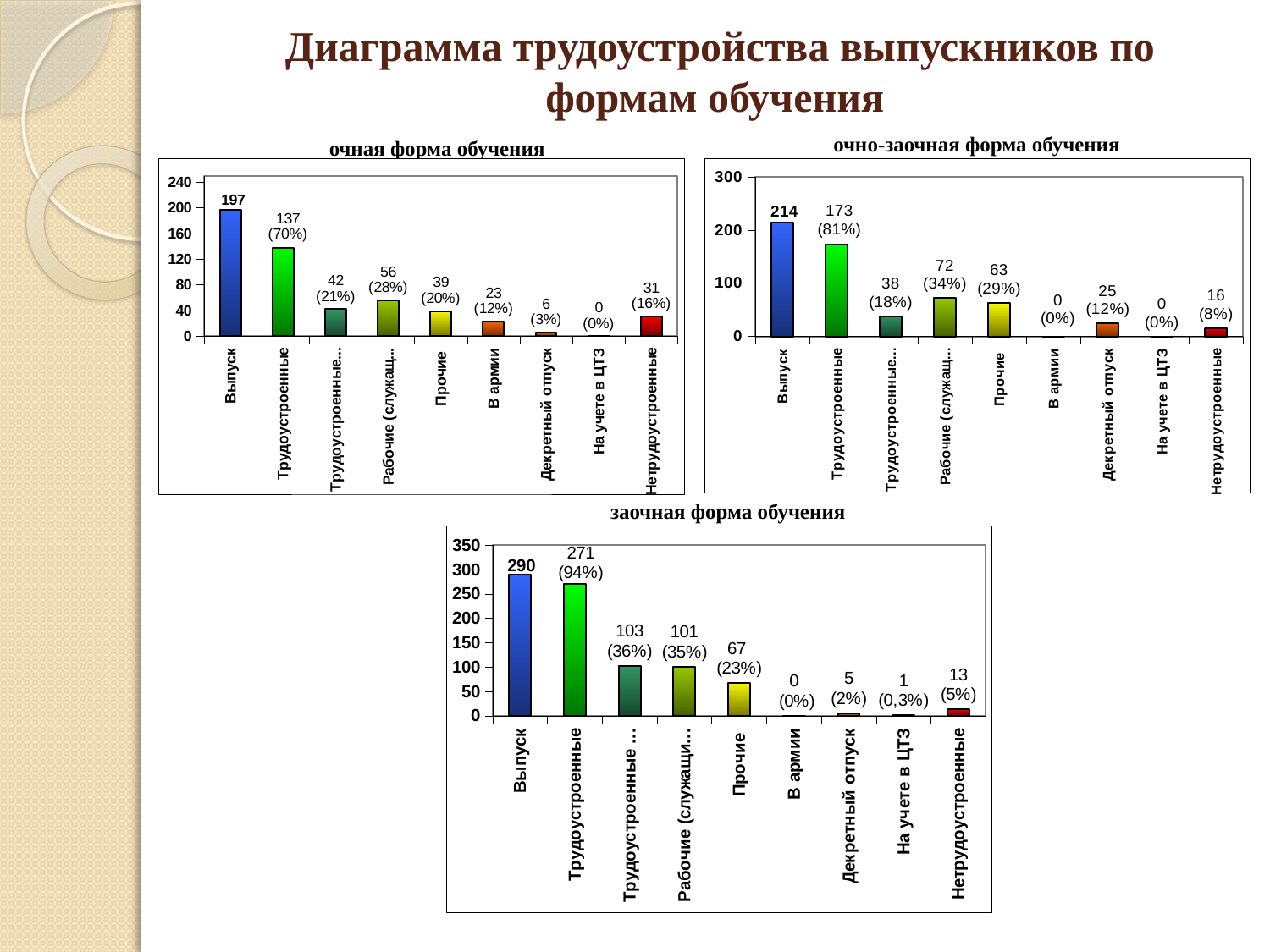
What type of chart is the chart titled 'очная форма обучения'? bar chart In the chart titled 'очно-заочная форма обучения', which is larger, 'Рабочие (служащ...' or 'Прочие'? Рабочие (служащ... In the chart titled 'очная форма обучения', what percentage is shown for 'Трудоустроенные'? 70% In the chart titled 'заочная форма обучения', what is the difference between 'Трудоустроенные ...' and 'Рабочие (служащи...'? 2 In the chart titled 'очно-заочная форма обучения', what is the value for 'Нетрудоустроенные'? 16 In the chart titled 'очная форма обучения', what is the difference between 'Выпуск' and 'Трудоустроенные'? 60 In the chart titled 'заочная форма обучения', what is the value for 'Трудоустроенные'? 271 In the chart titled 'заочная форма обучения', what percentage is shown for 'На учете в ЦТЗ'? 0,3% In the chart titled 'очно-заочная форма обучения', which category has the highest value? Выпуск How many categories are shown on the x axis of the chart titled 'заочная форма обучения'? 9 How many charts are shown on the slide? 3 In the chart titled 'очная форма обучения', what is the value for 'Выпуск'? 197